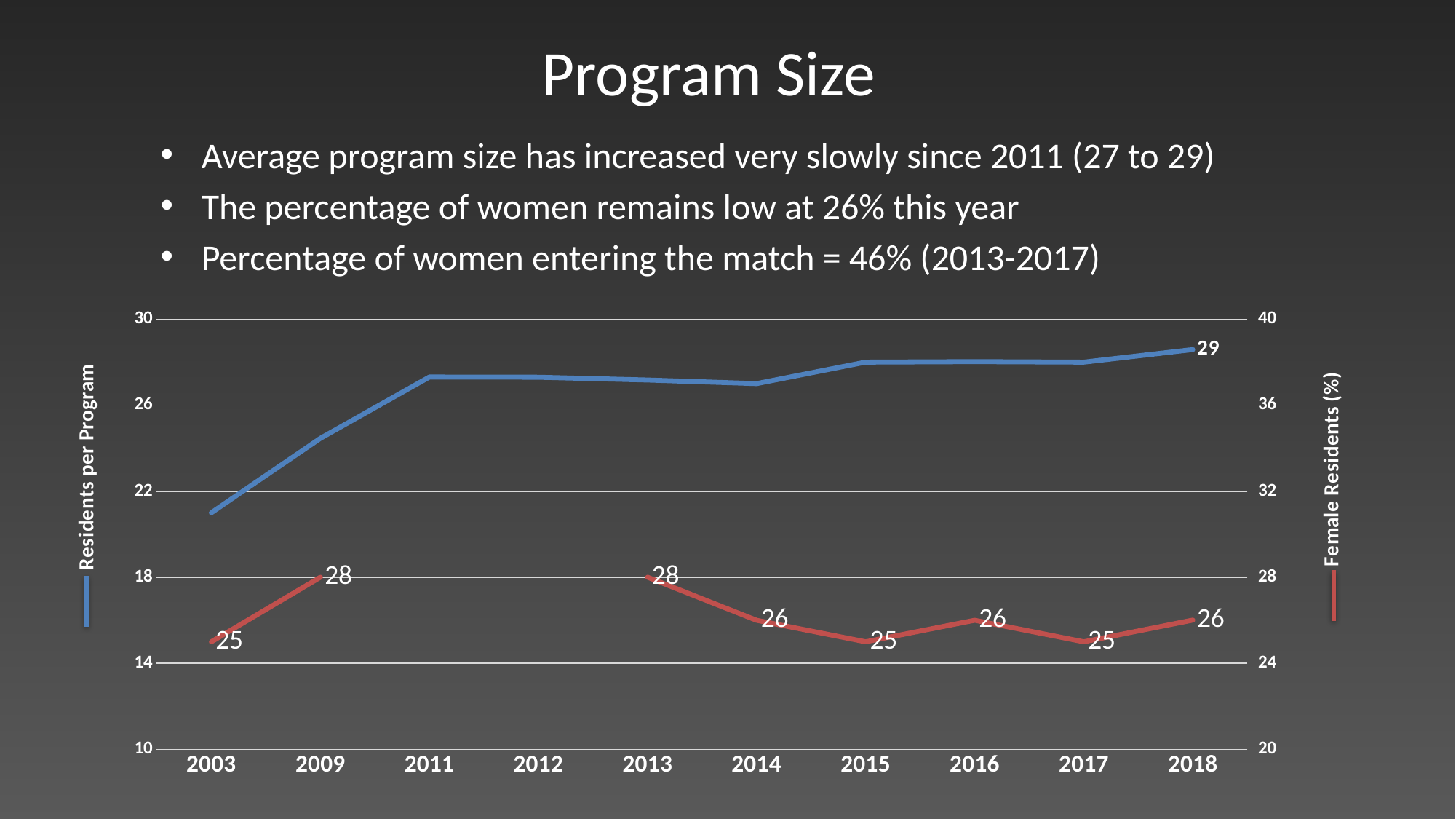
How many years are shown on the x axis? 10 In which year is the Residents per Program line at its lowest? 2003 What is the difference between the Female Residents (%) values for 2013 and 2015? 3 What kind of chart is shown on the slide? line chart Which year has the higher Female Residents (%) value, 2014 or 2015? 2014 What is the Female Residents (%) value for 2009? 28 In which year is the Residents per Program line at its highest? 2018 How many series are plotted on the chart? 2 What is the Female Residents (%) value for 2018? 26 Is the Residents per Program value for 2003 greater or less than 22? less What is the Residents per Program value for 2018? 29 Does the Residents per Program line rise or fall from 2003 to 2011? rise